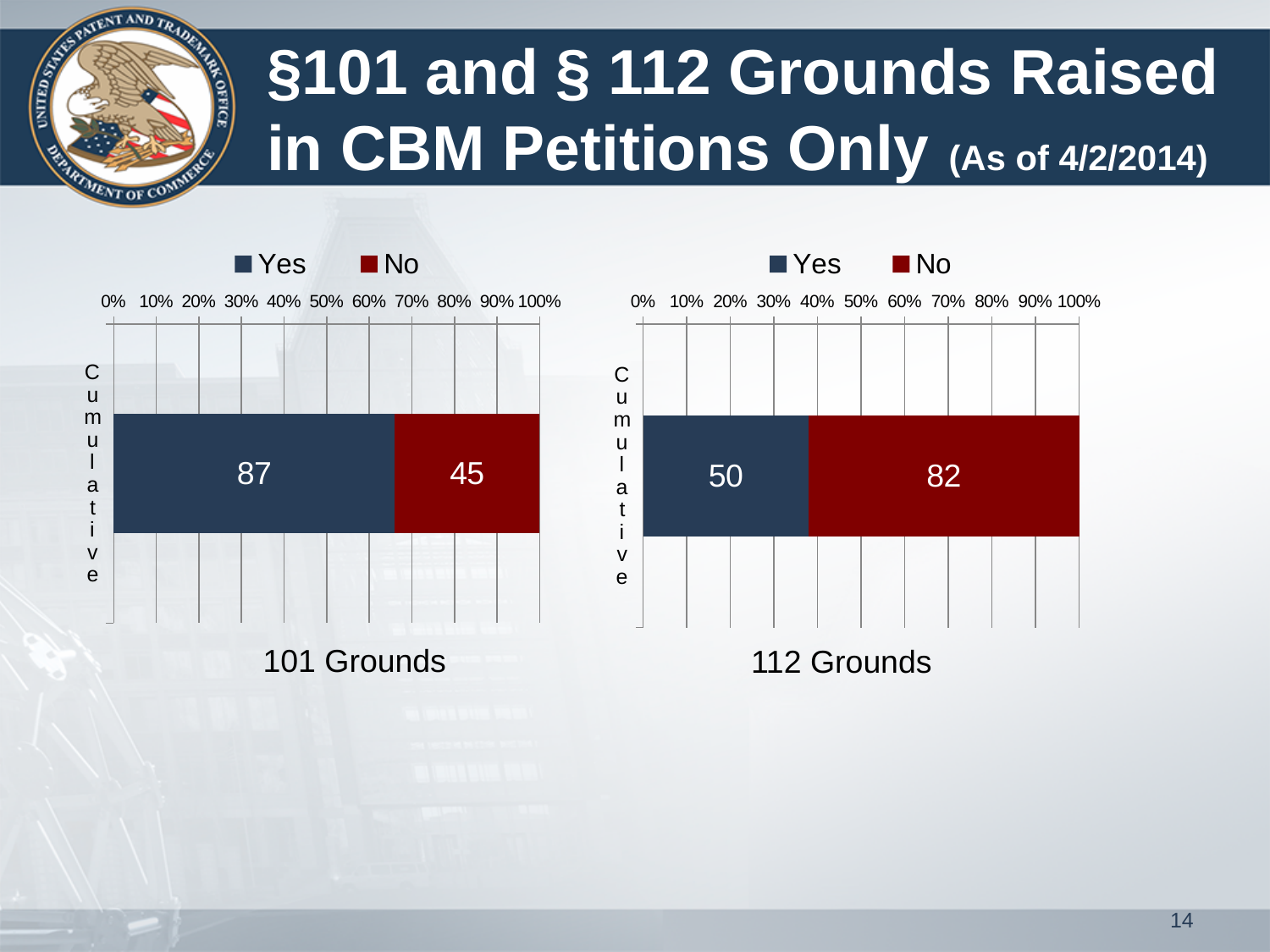
In the 112 Grounds chart, what is the value for Yes? 50 In the 101 Grounds chart, which series is larger, Yes or No? Yes In the 112 Grounds chart, which series is larger, Yes or No? No In the 101 Grounds chart, what is the value for No? 45 In the 112 Grounds chart, what is the total of the stacked bar? 132 In the 101 Grounds chart, what is the value for Yes? 87 How many series does the legend of the 112 Grounds chart list? 2 In the 112 Grounds chart, what is the value for No? 82 In the 101 Grounds chart, what is the difference between the Yes and No values? 42 In the 101 Grounds chart, what is the total of the stacked bar? 132 What kind of chart is the 101 Grounds chart? Stacked bar chart In the 112 Grounds chart, what is the difference between the No and Yes values? 32